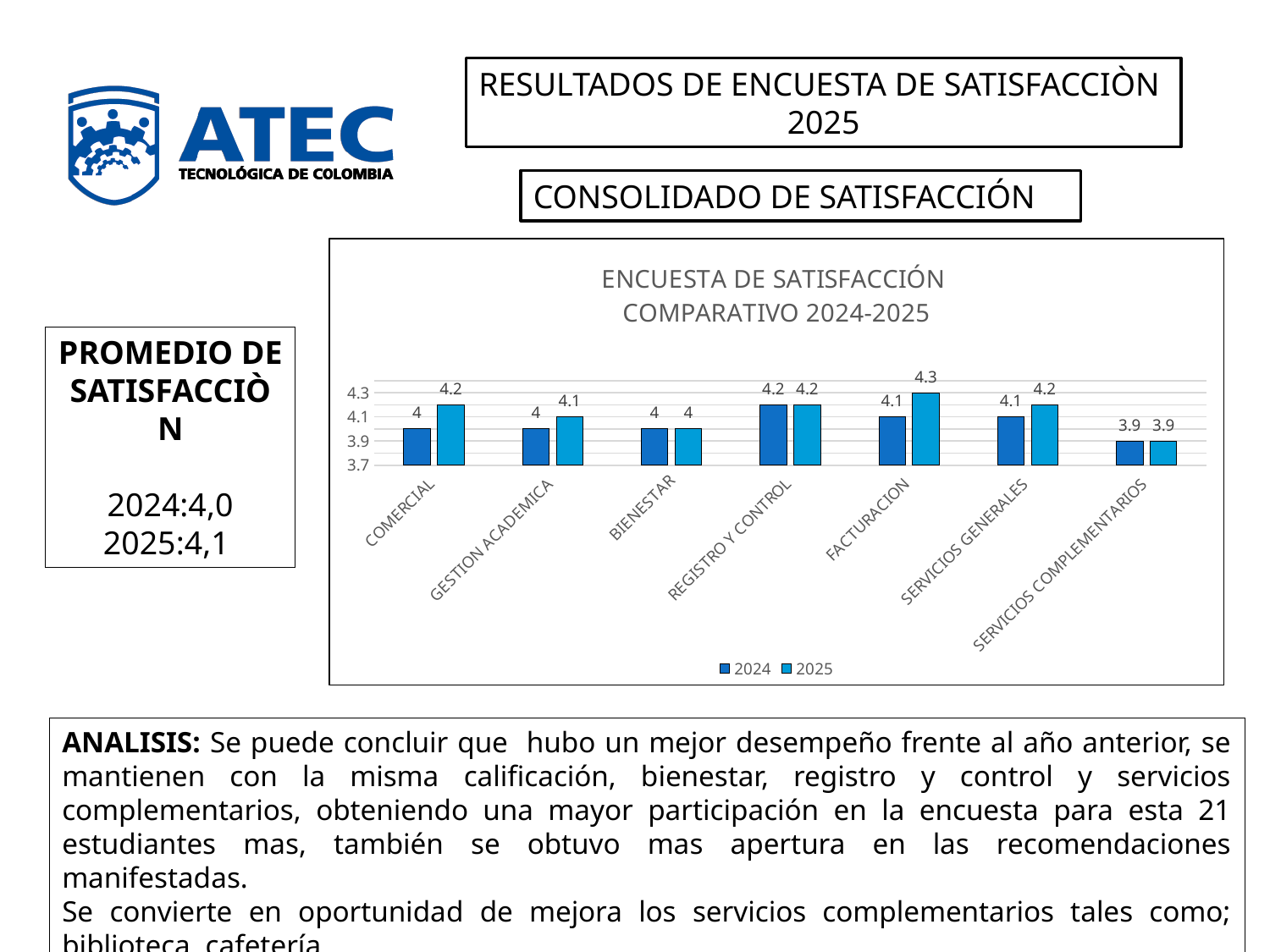
How many categories are shown on the x axis? 7 Which category has the highest 2025 value? FACTURACION What kind of chart is shown? Bar chart Which is larger for GESTION ACADEMICA, the 2024 value or the 2025 value? 2025 What is the 2024 value for FACTURACION? 4.1 How many series does the legend list? 2 What is the difference between the 2025 and 2024 values for FACTURACION? 0.2 What are the two series listed in the legend? 2024 and 2025 Which category has the lowest 2024 value? SERVICIOS COMPLEMENTARIOS What is the title of the chart? ENCUESTA DE SATISFACCIÓN COMPARATIVO 2024-2025 What is the 2025 value for COMERCIAL? 4.2 What is the 2025 value for SERVICIOS COMPLEMENTARIOS? 3.9